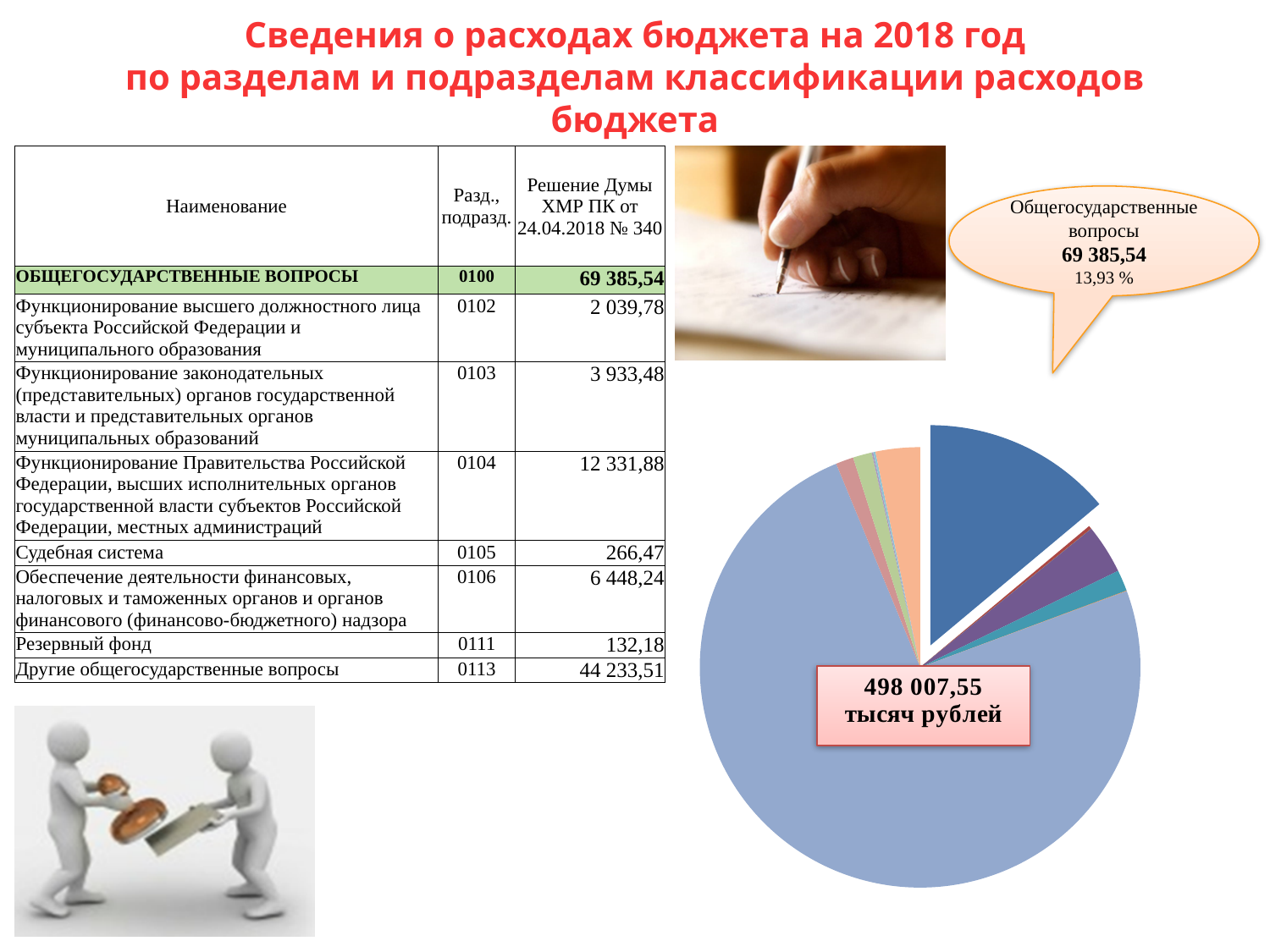
Does the pie chart have a legend? no Which slice of the pie chart is pulled out (exploded) from the rest? Общегосударственные вопросы What total value is printed in the centre label of the pie chart? 498 007,55 тысяч рублей In the pie chart, what value is shown in the callout for Общегосударственные вопросы? 69 385,54 In the pie chart, what share of the total does the Общегосударственные вопросы slice represent, according to the callout? 13,93 % Is the Общегосударственные вопросы slice the largest slice of the pie chart? no Is the share of the Общегосударственные вопросы slice greater or less than 50%? less What kind of chart is shown on the right side of the slide? pie chart